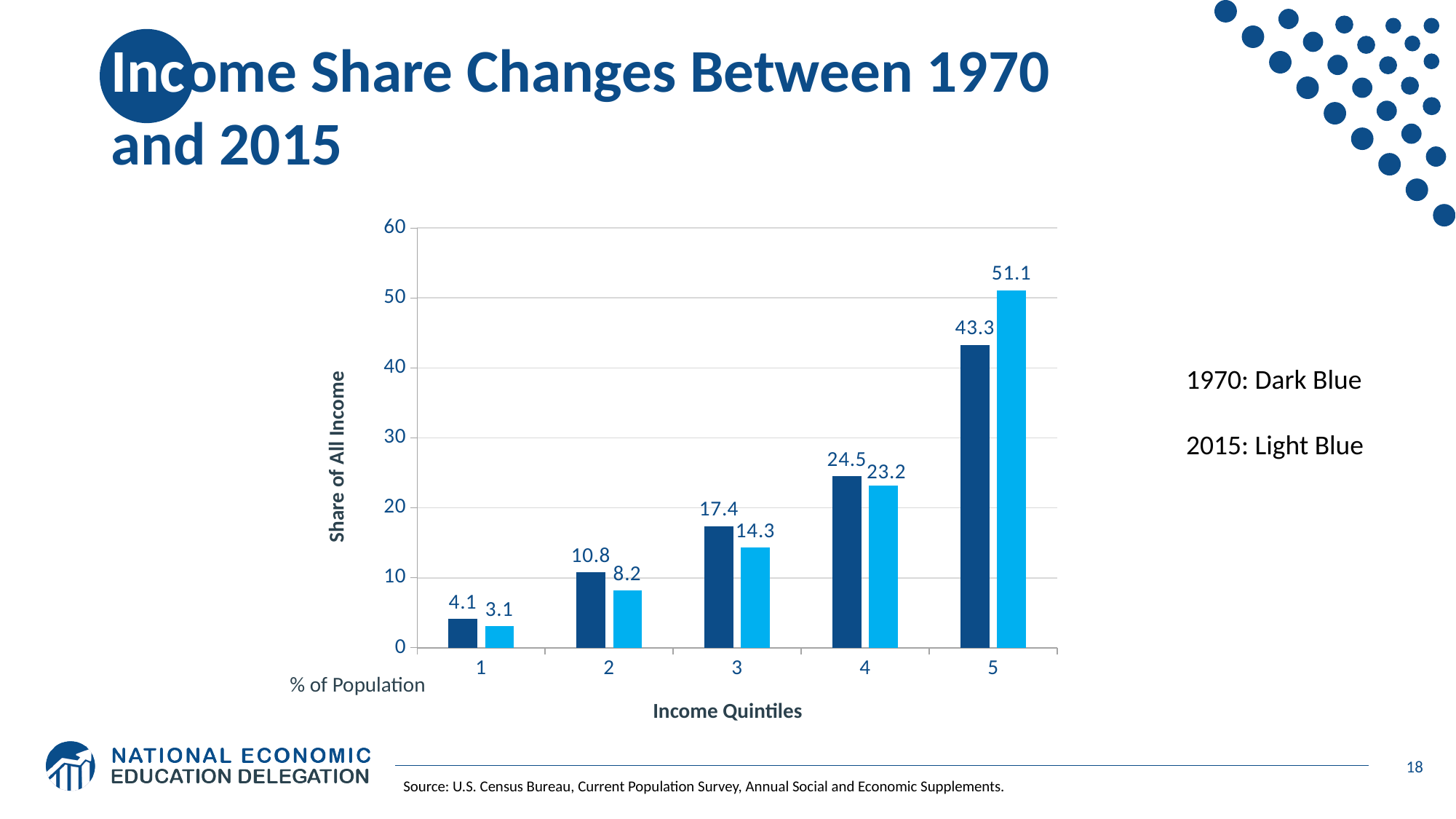
For income quintile 4, which year has the larger income share, 1970 or 2015? 1970 What type of chart is shown on the slide? Bar chart Which colour represents the year 2015 in the chart? Light Blue What is the 1970 income share for income quintile 5? 43.3 Which income quintile has the highest 2015 income share? 5 What is the 2015 income share for income quintile 1? 3.1 What is the difference between the 2015 and 1970 income shares for quintile 5? 7.8 What is the 2015 income share for income quintile 3? 14.3 What is the difference between the 1970 and 2015 income shares for quintile 2? 2.6 Do the 1970 income shares rise or fall as the income quintile increases from 1 to 5? Rise Which income quintile has the lowest 1970 income share? 1 How many income quintiles are shown on the x axis? 5